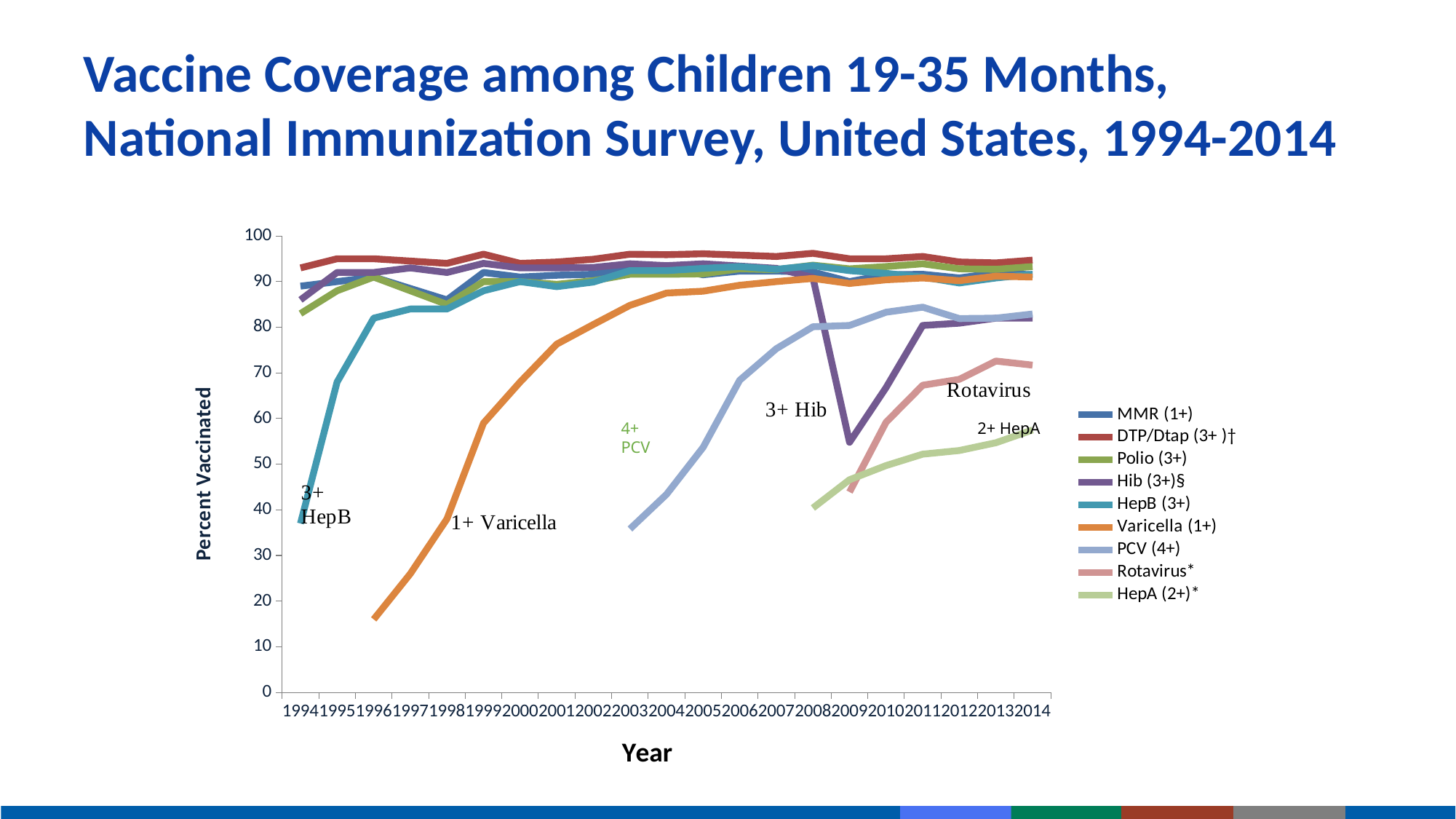
Is the value for Varicella (1+) in 1996 greater or less than 20? less What is the label on the y axis of the chart? Percent Vaccinated Is the value for DTP/Dtap (3+)† in 2014 greater or less than 90? greater In 2009, which is larger: Hib (3+)§ or DTP/Dtap (3+)†? DTP/Dtap (3+)† What kind of chart is shown on the slide? Line chart Is the value for PCV (4+) in 2003 greater or less than 40? less How many series does the legend list? 9 In 2003, which is larger: PCV (4+) or Varicella (1+)? Varicella (1+) How many years are shown along the x axis? 21 Does the Varicella (1+) line rise or fall from 1996 to 2014? rise